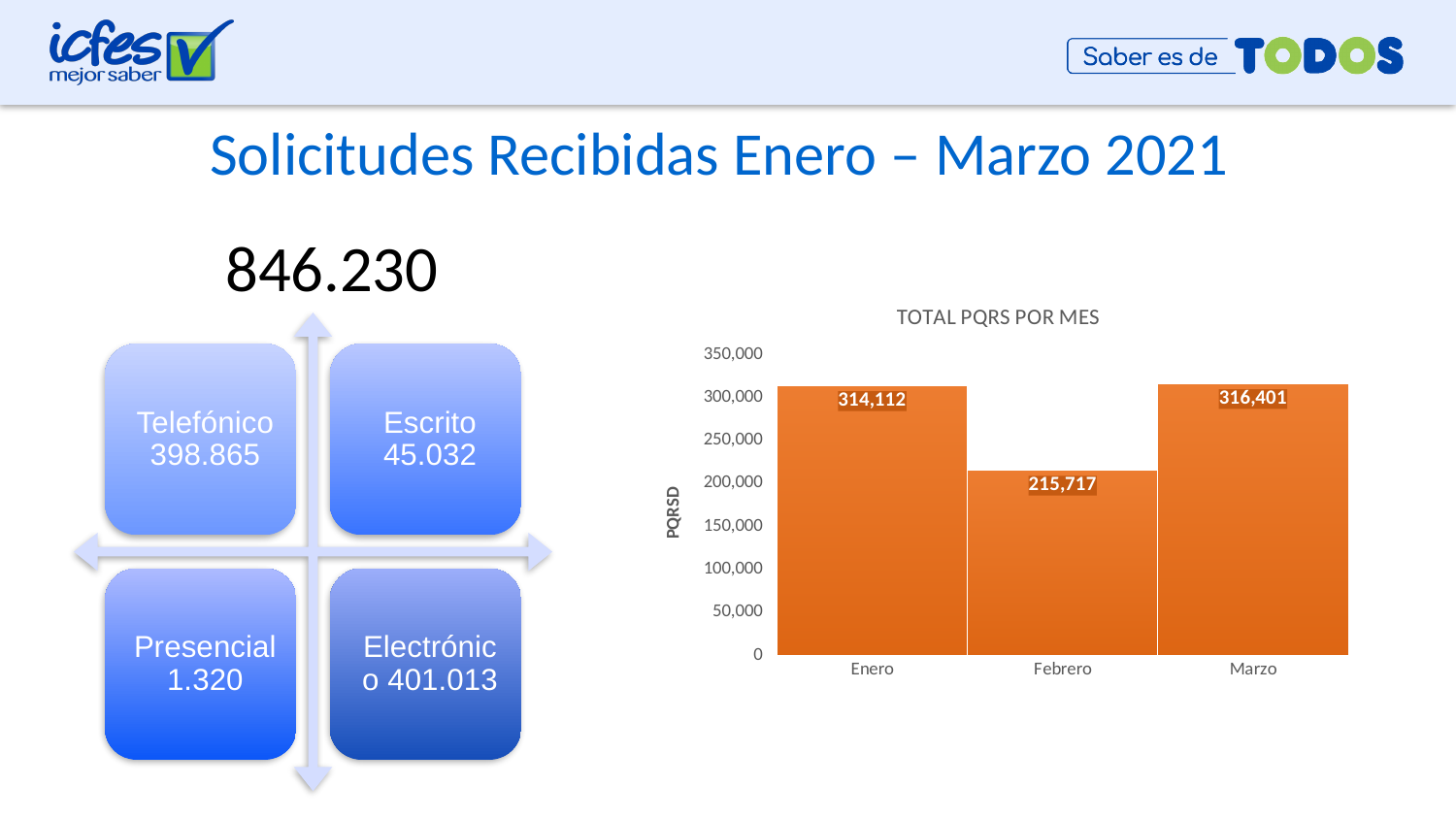
Which month has the highest value in the chart? Marzo What is the label on the vertical axis of the chart? PQRSD What is the difference between the values for Marzo and Febrero? 100,684 What is the title of the chart? TOTAL PQRS POR MES How many months are shown on the x axis of the chart? 3 What kind of chart is shown on the slide? Bar chart What is the difference between the values for Enero and Febrero? 98,395 Which month has the lowest value in the chart? Febrero What is the value for Marzo in the chart? 316,401 What is the value for Enero in the chart? 314,112 Is the value for Febrero greater or less than 250,000? less What is the value for Febrero in the chart? 215,717